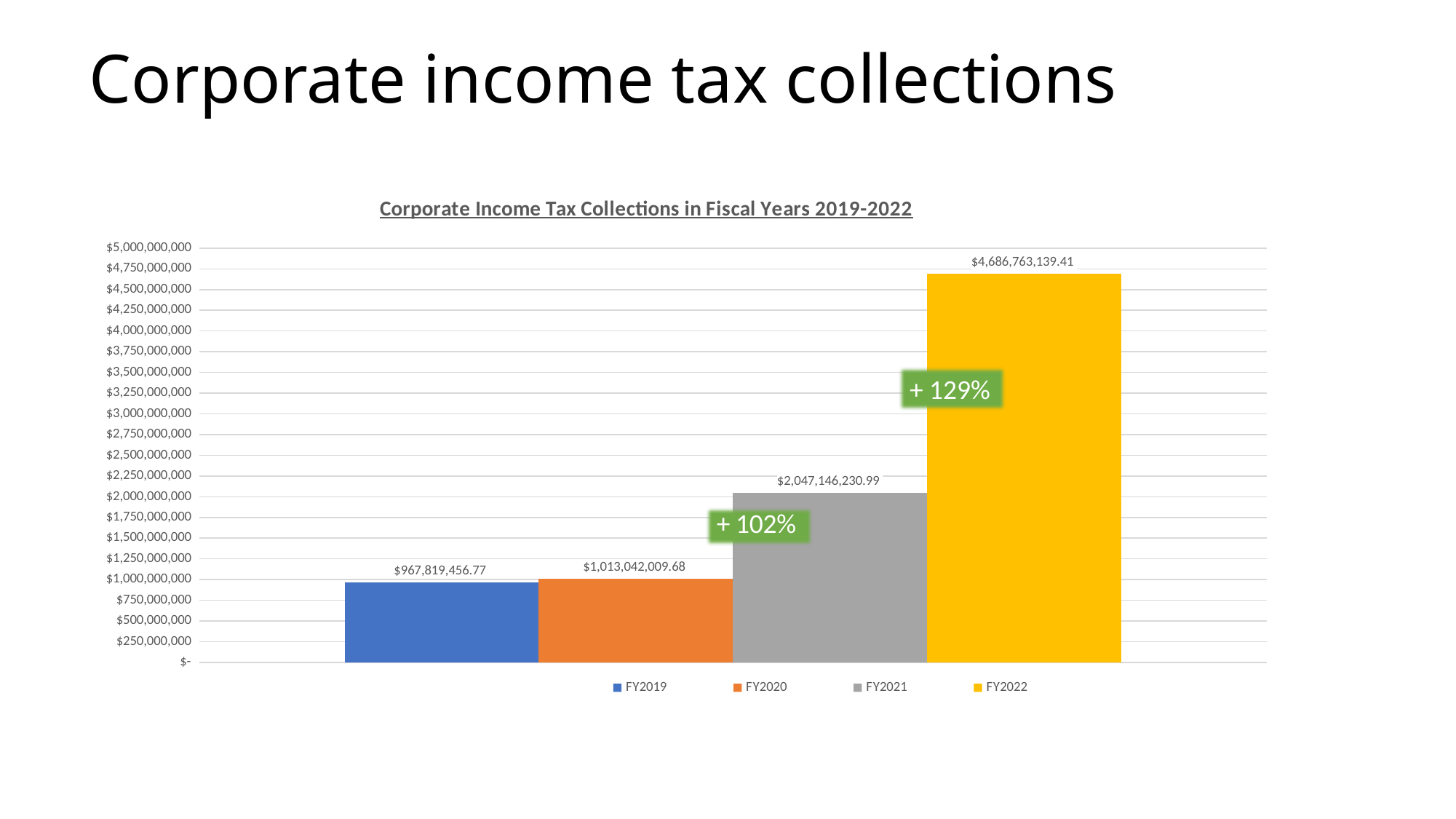
How many fiscal years are plotted in the chart? 4 Which is larger, the value for FY2021 or the value for FY2020? FY2021 Which fiscal year has the highest collections? FY2022 What is the value for FY2019? $967,819,456.77 What is the value for FY2020? $1,013,042,009.68 Do the collections rise or fall from FY2019 to FY2022? Rise Which fiscal year has the lowest collections? FY2019 What is the value for FY2022? $4,686,763,139.41 What kind of chart is shown on the slide? Bar chart What is the difference between the FY2022 and FY2021 values? $2,639,616,908.42 What is the difference between the FY2020 and FY2019 values? $45,222,552.91 What is the value for FY2021? $2,047,146,230.99